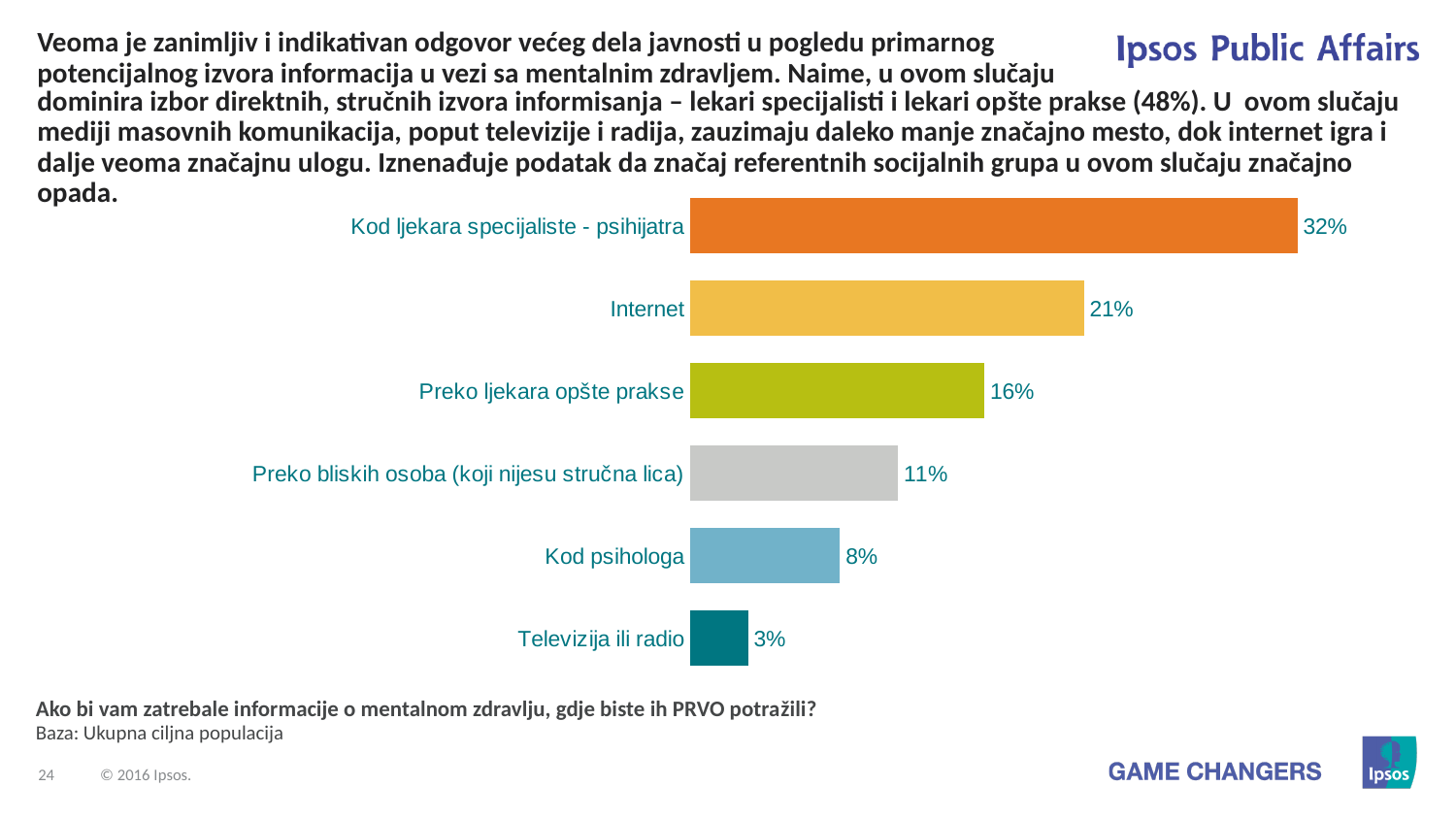
What is the value for Kod psihologa? 8% What is the combined value of Kod ljekara specijaliste - psihijatra and Preko ljekara opšte prakse? 48% Which category has the lowest value? Televizija ili radio What is the difference between the values for Preko ljekara opšte prakse and Televizija ili radio? 13% Which is larger, the value for Preko ljekara opšte prakse or the value for Kod psihologa? Preko ljekara opšte prakse What is the difference between the values for Kod ljekara specijaliste - psihijatra and Internet? 11% Which category has the highest value? Kod ljekara specijaliste - psihijatra What colour is the bar for Internet? Yellow What is the value for Preko bliskih osoba (koji nijesu stručna lica)? 11% What is the value for Internet? 21% How many categories are shown in the chart? 6 What kind of chart is shown on the slide? Bar chart